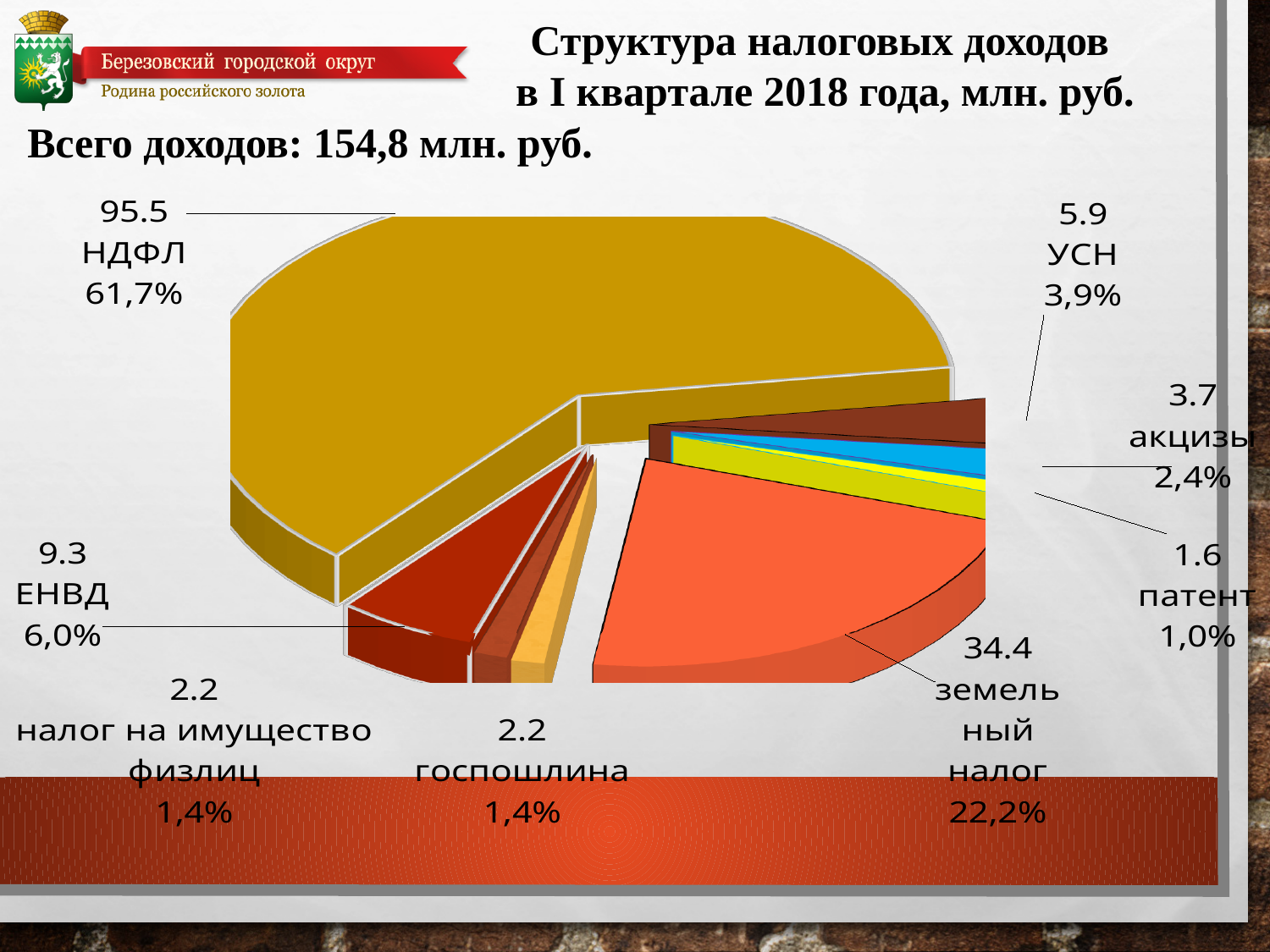
Which category has the smallest slice of the pie? патент What total income is stated on the slide? 154,8 млн. руб. Which category has the largest slice of the pie? НДФЛ What kind of chart is shown on the slide? pie chart What is the value for НДФЛ? 95.5 What is the value for ЕНВД? 9.3 Which is larger, the value for УСН or the value for акцизы? УСН What share of the pie does земельный налог have? 22,2% What is the value for патент? 1.6 What share of the pie does УСН have? 3,9% What is the difference between the values for НДФЛ and земельный налог? 61.1 How many categories are shown in the pie chart? 8